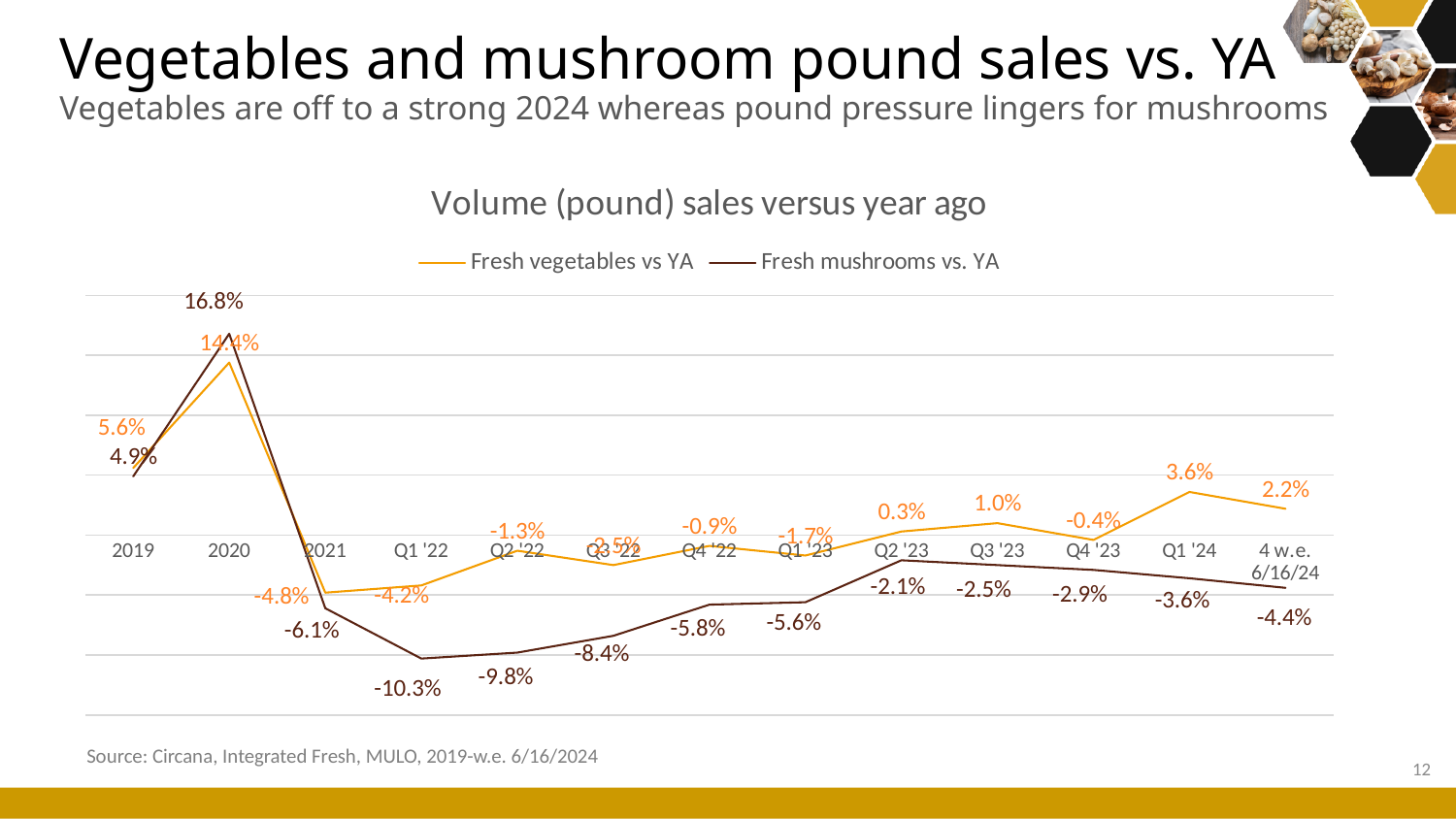
How many series does the legend list? 2 What is the value for Fresh mushrooms vs. YA for the 4 w.e. 6/16/24 period? -4.4% In which period is the Fresh mushrooms vs. YA value lowest? Q1 '22 What is the value for Fresh mushrooms vs. YA in 2020? 16.8% In 2020, which series has the higher value, Fresh vegetables vs YA or Fresh mushrooms vs. YA? Fresh mushrooms vs. YA How many periods are plotted along the x axis? 13 What kind of chart is shown on the slide? Line chart Do the Fresh mushrooms vs. YA values rise or fall from Q2 '23 to 4 w.e. 6/16/24? Fall What is the difference between the Fresh vegetables vs YA value and the Fresh mushrooms vs. YA value in Q1 '24? 7.2 percentage points What is the value for Fresh vegetables vs YA in Q1 '24? 3.6% What is the value for Fresh vegetables vs YA in Q4 '23? -0.4% In which period is the Fresh vegetables vs YA value highest? 2020